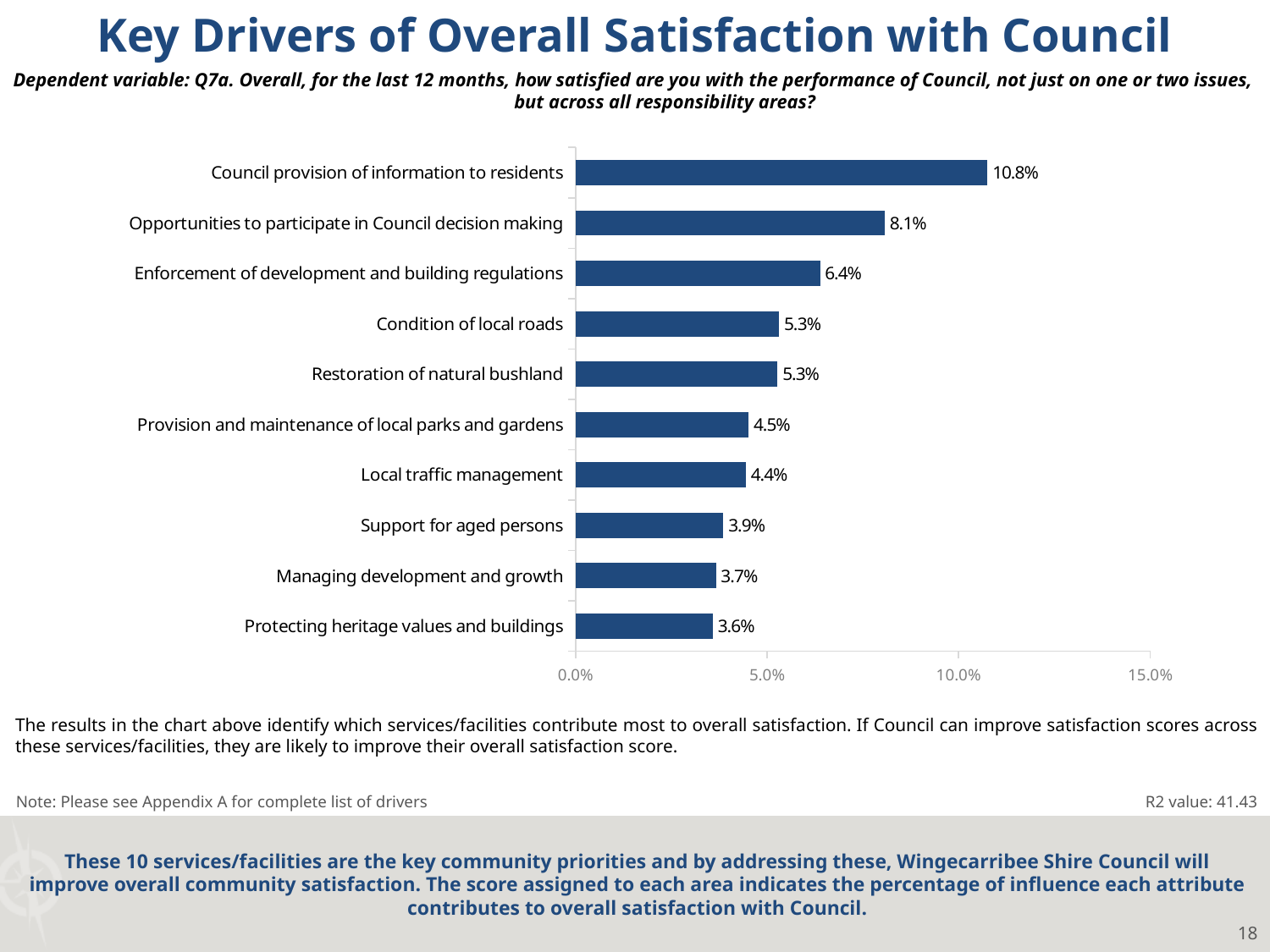
What is the value for Protecting heritage values and buildings? 3.6% How many categories are shown in the chart? 10 What is the R2 value shown on the slide? 41.43 What is the value for Managing development and growth? 3.7% Is the value for Opportunities to participate in Council decision making greater or less than 10.0%? less Which category has the highest value? Council provision of information to residents What is the value for Council provision of information to residents? 10.8% Which is larger: the value for Enforcement of development and building regulations or the value for Support for aged persons? Enforcement of development and building regulations What kind of chart is shown on the slide? Bar chart What is the difference between the values for Council provision of information to residents and Opportunities to participate in Council decision making? 2.7% Which category has the lowest value? Protecting heritage values and buildings What is the value for Local traffic management? 4.4%